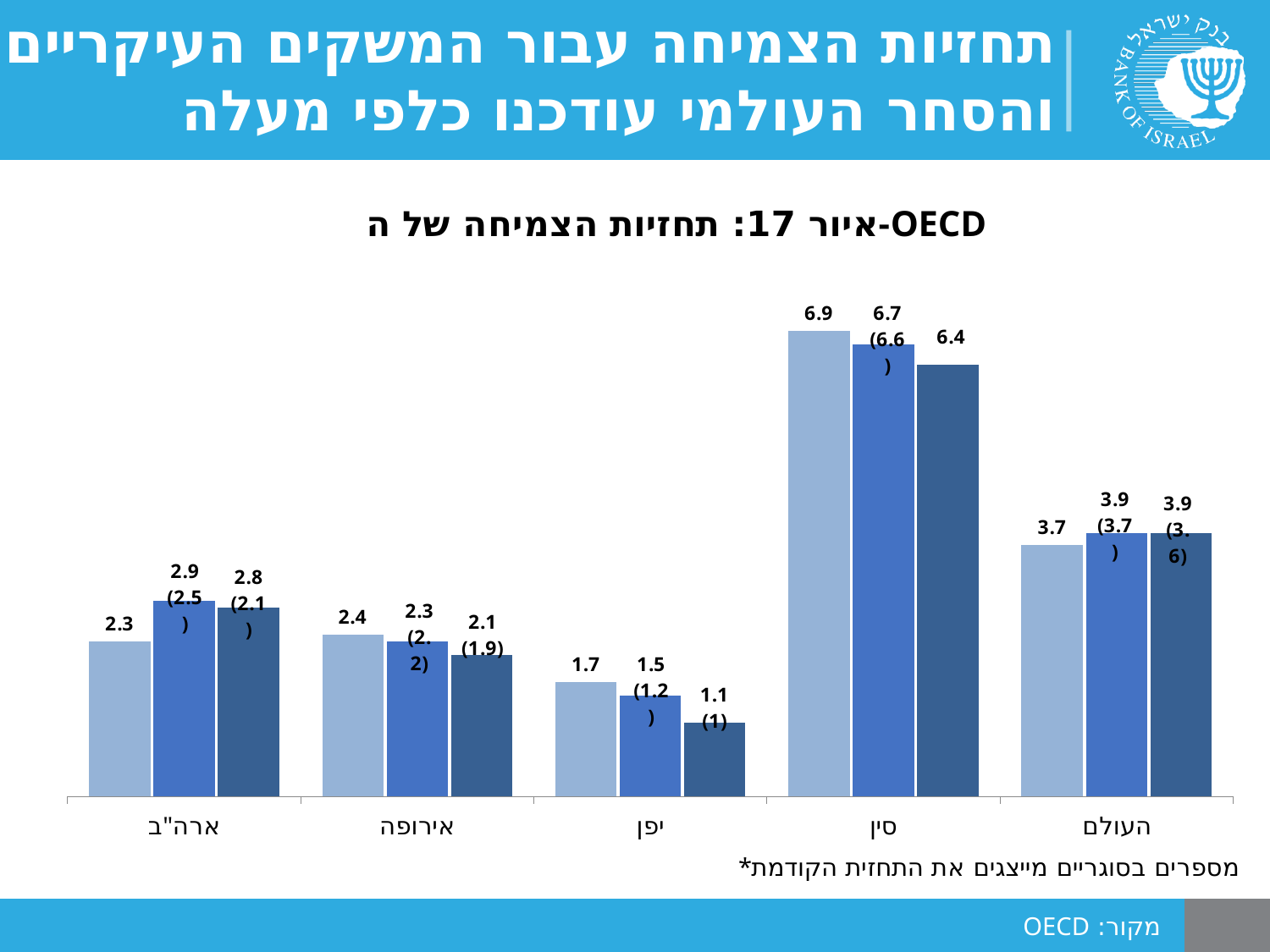
What type of chart is shown on the slide? bar chart Which category has the lowest bars in the chart? יפן What is the difference between the light blue bar for סין (6.9) and the dark blue bar for סין (6.4)? 0.5 Which category has the highest bars in the chart? סין What is the value of the light blue (leftmost) bar for העולם (World)? 3.7 What is the value of the dark blue (rightmost) bar for יפן (Japan)? 1.1 What is the value of the medium blue (middle) bar for ארה"ב (USA)? 2.9 What is the source cited at the bottom of the slide? OECD What is the value of the light blue (leftmost) bar for סין (China)? 6.9 Which is larger: the light blue bar for אירופה or the light blue bar for ארה"ב? אירופה What is the previous forecast shown in parentheses for the middle bar of יפן (Japan)? 1.2 How many categories (regions) are shown on the x axis of the chart? 5